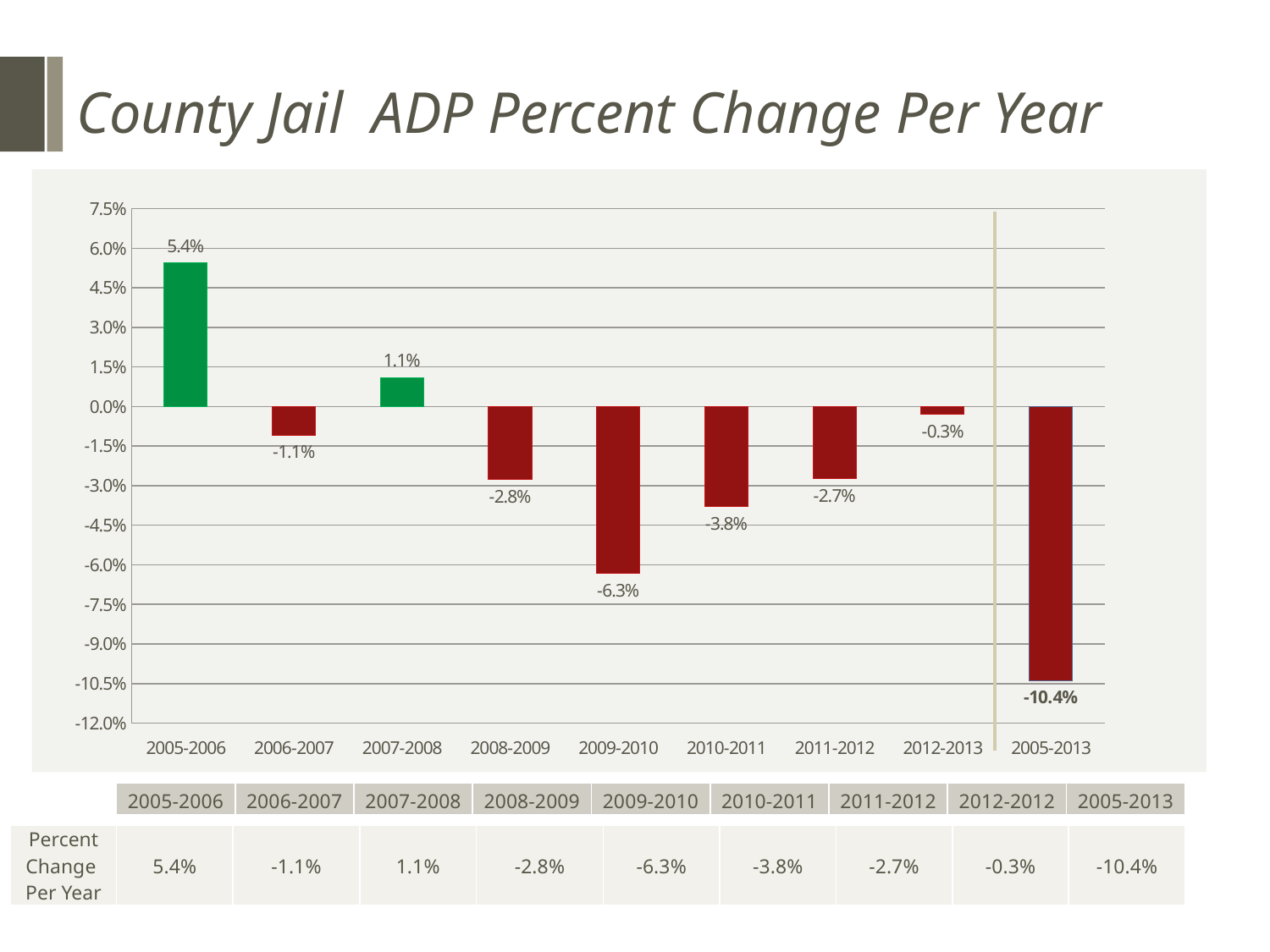
What colour are the bars with positive percent change? Green Which period has the highest percent change? 2005-2006 What is the percent change for 2012-2013? -0.3% What is the percent change for 2009-2010? -6.3% What is the title of the chart? County Jail ADP Percent Change Per Year What is the difference between the percent change for 2005-2006 and 2007-2008? 4.3% What kind of chart is shown on the slide? Bar chart Which period has the lowest percent change? 2005-2013 What is the overall percent change for 2005-2013? -10.4% How many bars are shown in the chart? 9 What is the percent change for 2005-2006? 5.4% Which is larger, the percent change for 2010-2011 or 2011-2012? 2011-2012